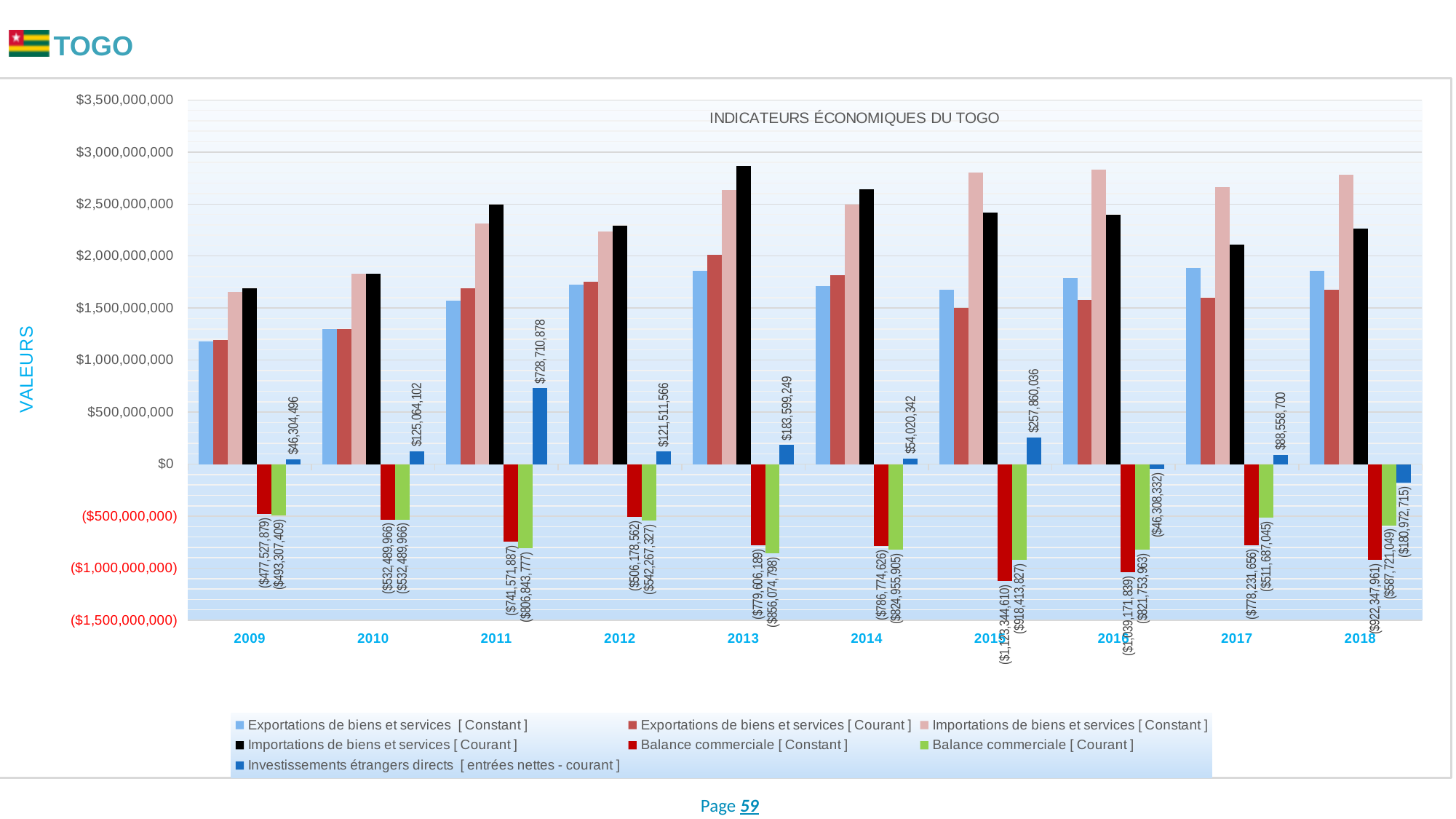
What is the value of Investissements étrangers directs in 2011? $728,710,878 How many years are shown on the x axis of the chart? 10 Do the values for Importations de biens et services [Courant] rise or fall from 2009 to 2013? rise What is the value of Balance commerciale [Courant] in 2013? ($856,074,798) How many series does the legend list? 7 In which year is Investissements étrangers directs the highest? 2011 What is the difference between Investissements étrangers directs in 2013 and in 2014? $129,578,907 What is the value of Balance commerciale [Constant] in 2009? ($477,527,879) Which is larger, Investissements étrangers directs in 2010 or in 2012? 2010 Is the value for Importations de biens et services [Courant] in 2013 greater or less than $2,500,000,000? greater What is the title of the chart? INDICATEURS ÉCONOMIQUES DU TOGO What kind of chart is shown on the slide? bar chart